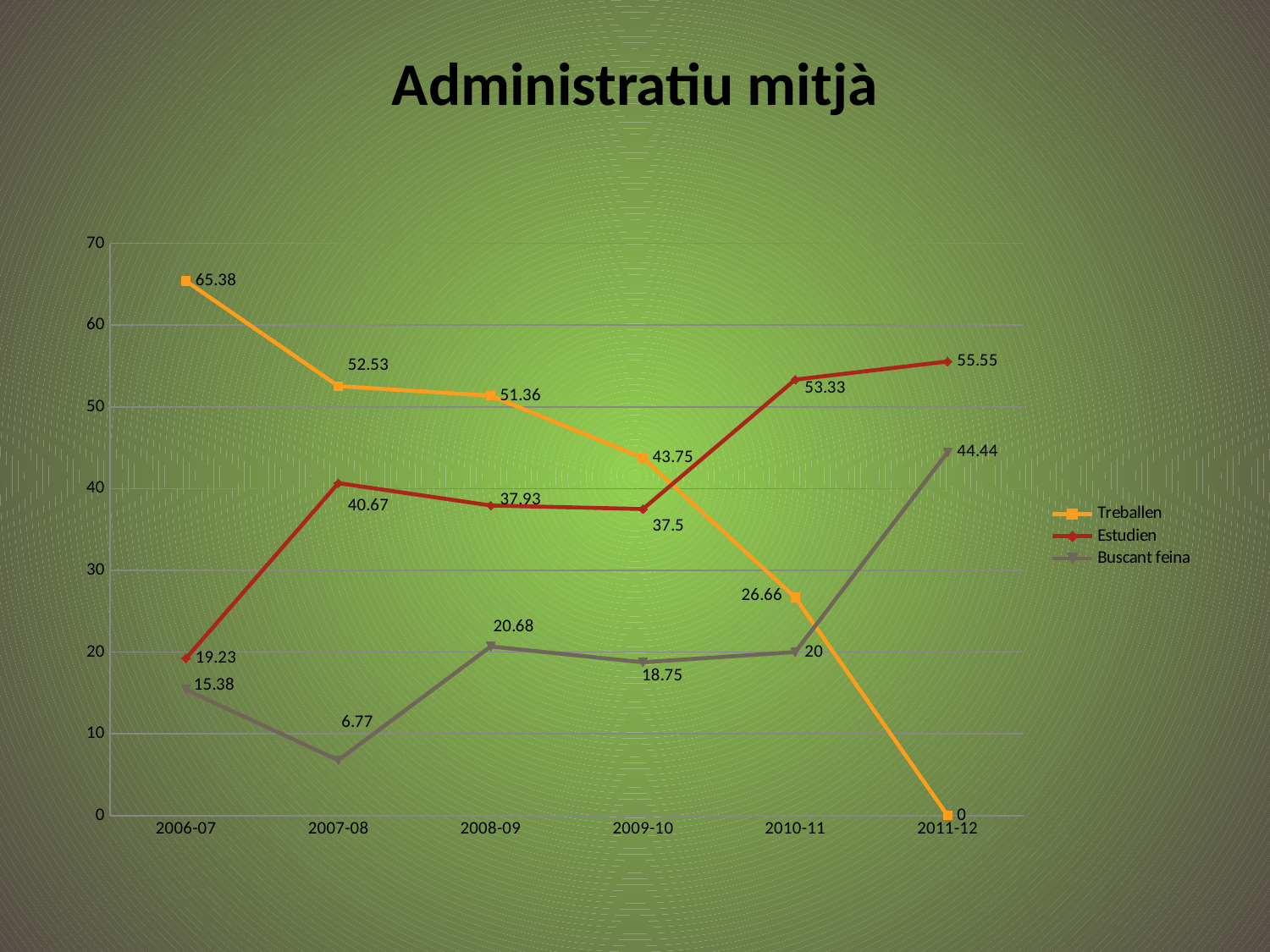
What is the value for Estudien in 2011-12? 55.55 Is the value for Buscant feina in 2011-12 greater or less than 40? greater What is the value for Buscant feina in 2007-08? 6.77 What is the difference between Treballen and Estudien in 2010-11? 26.67 In which year is the Treballen series lowest? 2011-12 In which year is the Estudien series highest? 2011-12 What is the value for Treballen in 2006-07? 65.38 Does the Treballen series rise or fall from 2006-07 to 2011-12? fall Which is larger in 2009-10, Treballen or Estudien? Treballen How many years are shown on the x axis? 6 What kind of chart is shown? line chart How many series does the legend list? 3